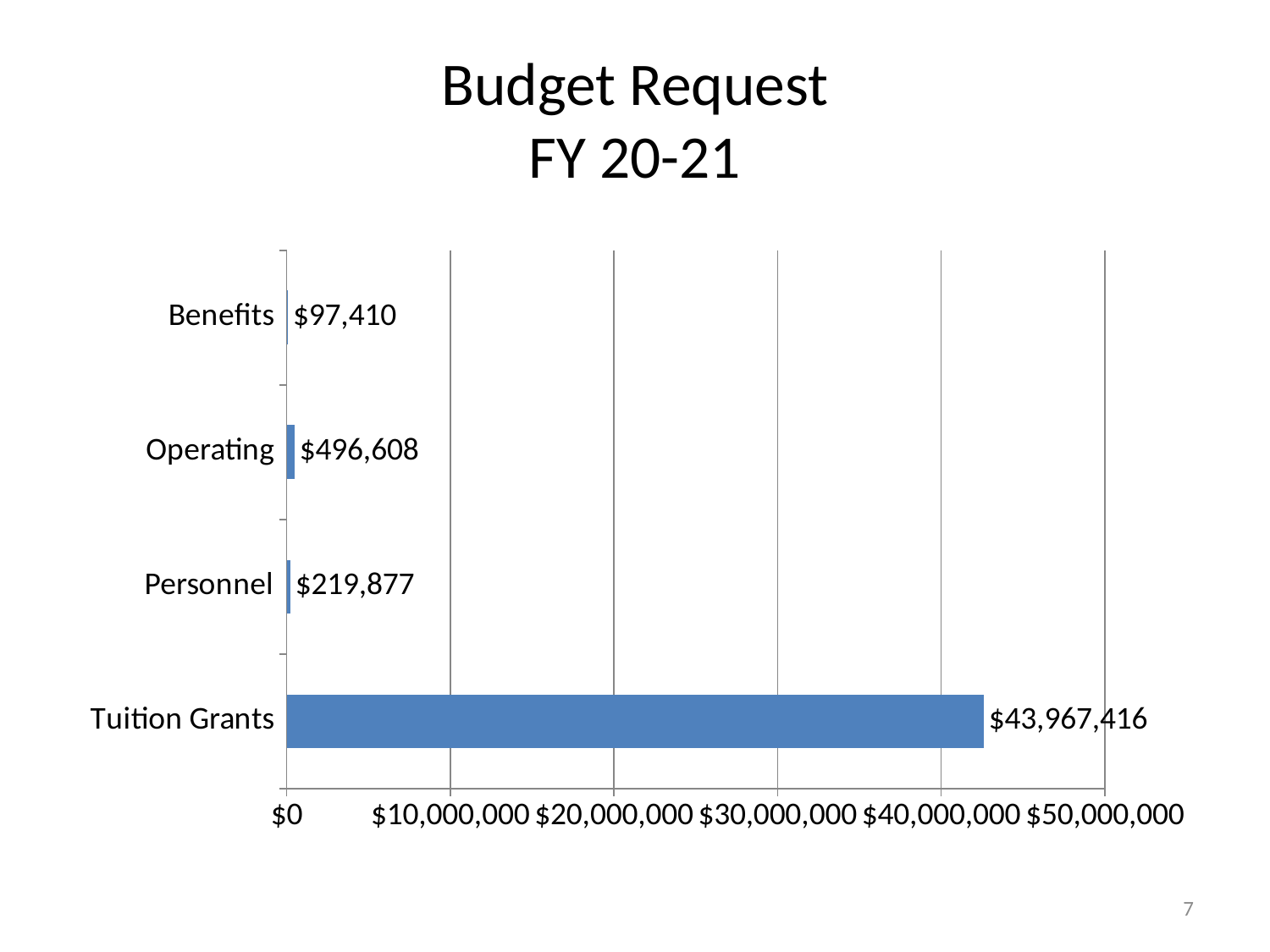
What is the value for Personnel? $219,877 How many categories are shown in the chart? 4 Is the value for Tuition Grants greater or less than $40,000,000? greater What kind of chart is shown on the slide? bar chart What is the value for Tuition Grants? $43,967,416 What is the title of the slide? Budget Request FY 20-21 What is the value for Operating? $496,608 Which category has the lowest value? Benefits Which is larger, the value for Operating or the value for Benefits? Operating What is the value for Benefits? $97,410 Which category has the highest value? Tuition Grants What is the difference between the Operating and Personnel values? $276,731